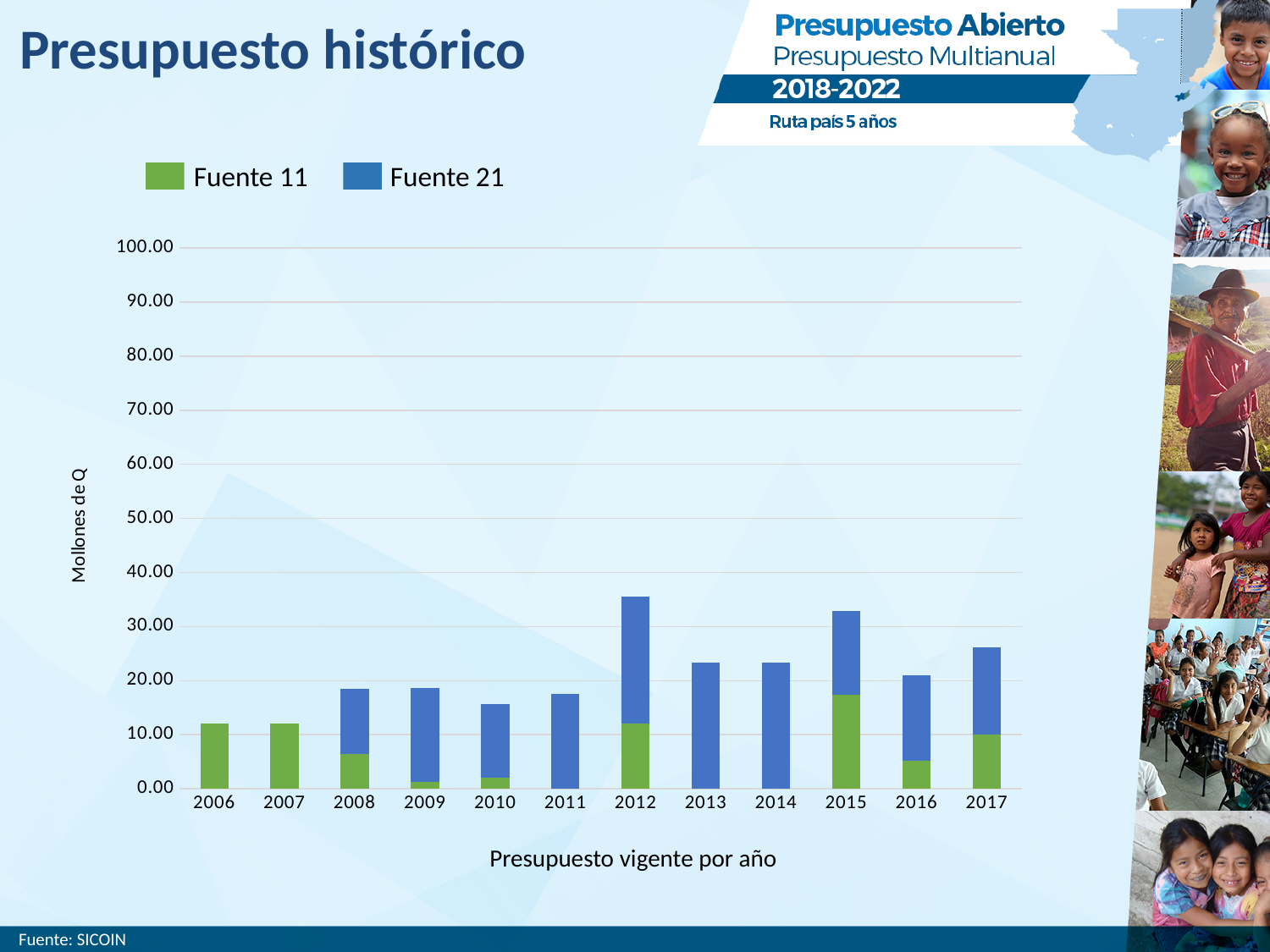
How many series does the chart legend list? 2 How many years are shown on the x axis of the chart? 12 What is the title of the vertical axis of the chart? Mollones de Q Is the total value for 2015 greater or less than 30.00? greater Is the total value for 2006 greater or less than 20.00? less Which year has the tallest total bar in the chart? 2012 Which series is shown in green in the chart? Fuente 11 Is the total value for 2012 greater or less than 30.00? greater Which year has a larger total bar, 2013 or 2008? 2013 Which year has a larger total bar, 2017 or 2016? 2017 What kind of chart is shown on the slide? stacked bar chart